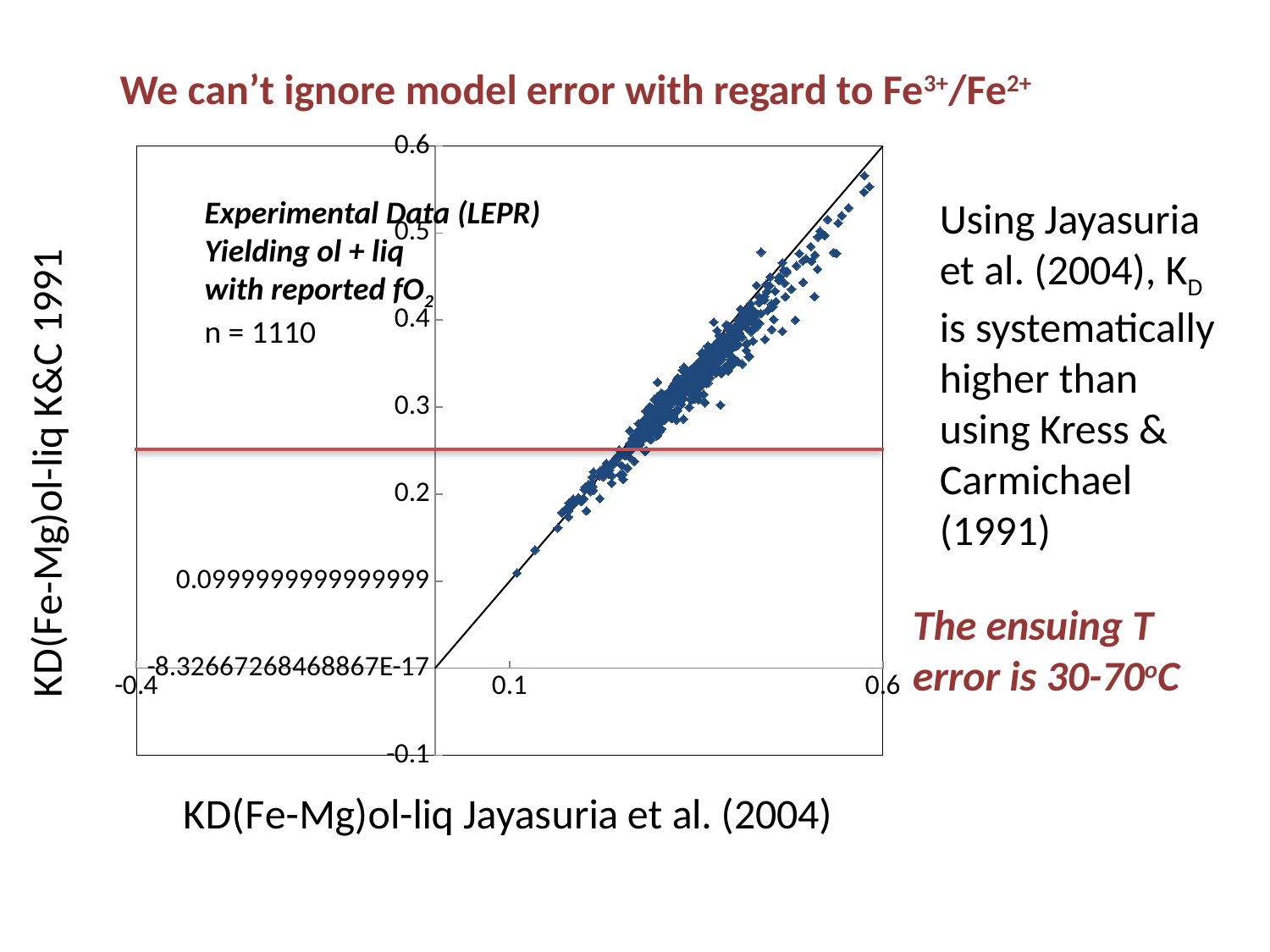
Is the y-axis value of the lowest plotted point greater or less than 0.2? less Is the y-axis value of the highest plotted point greater or less than 0.6? less What kind of chart is shown on the slide? scatter plot How many data points (n) does the chart annotation say are plotted? 1110 Is the y-axis value of the highest plotted point greater or less than 0.5? greater What is the label of the x axis of the chart? KD(Fe-Mg)ol-liq Jayasuria et al. (2004) What is the label of the y axis of the chart? KD(Fe-Mg)ol-liq K&C 1991 Do the plotted points rise or fall as the x-axis value increases? rise